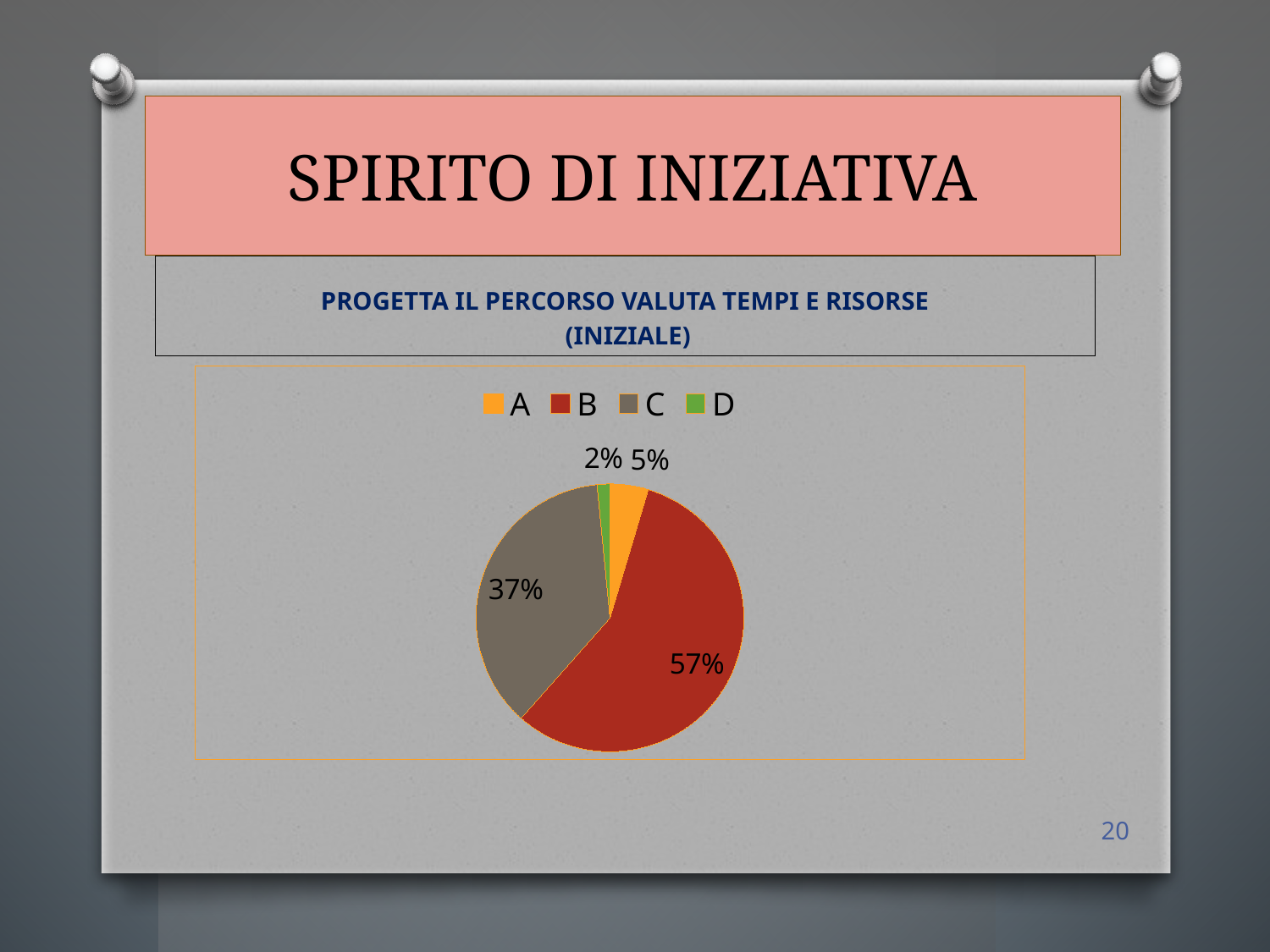
What kind of chart is shown on the slide? pie chart What percentage does category A have in the pie chart? 5% What percentage does category C have in the pie chart? 37% How many categories does the legend of the pie chart list? 4 What is the difference in percentage points between category B and category C? 20 What colour is the slice for category C in the pie chart? gray What percentage does category B have in the pie chart? 57% What is the combined share of categories A and D in the pie chart? 7% What percentage does category D have in the pie chart? 2% Which is larger in the pie chart, category A or category D? A Which category has the largest slice of the pie chart? B Which category has the smallest slice of the pie chart? D